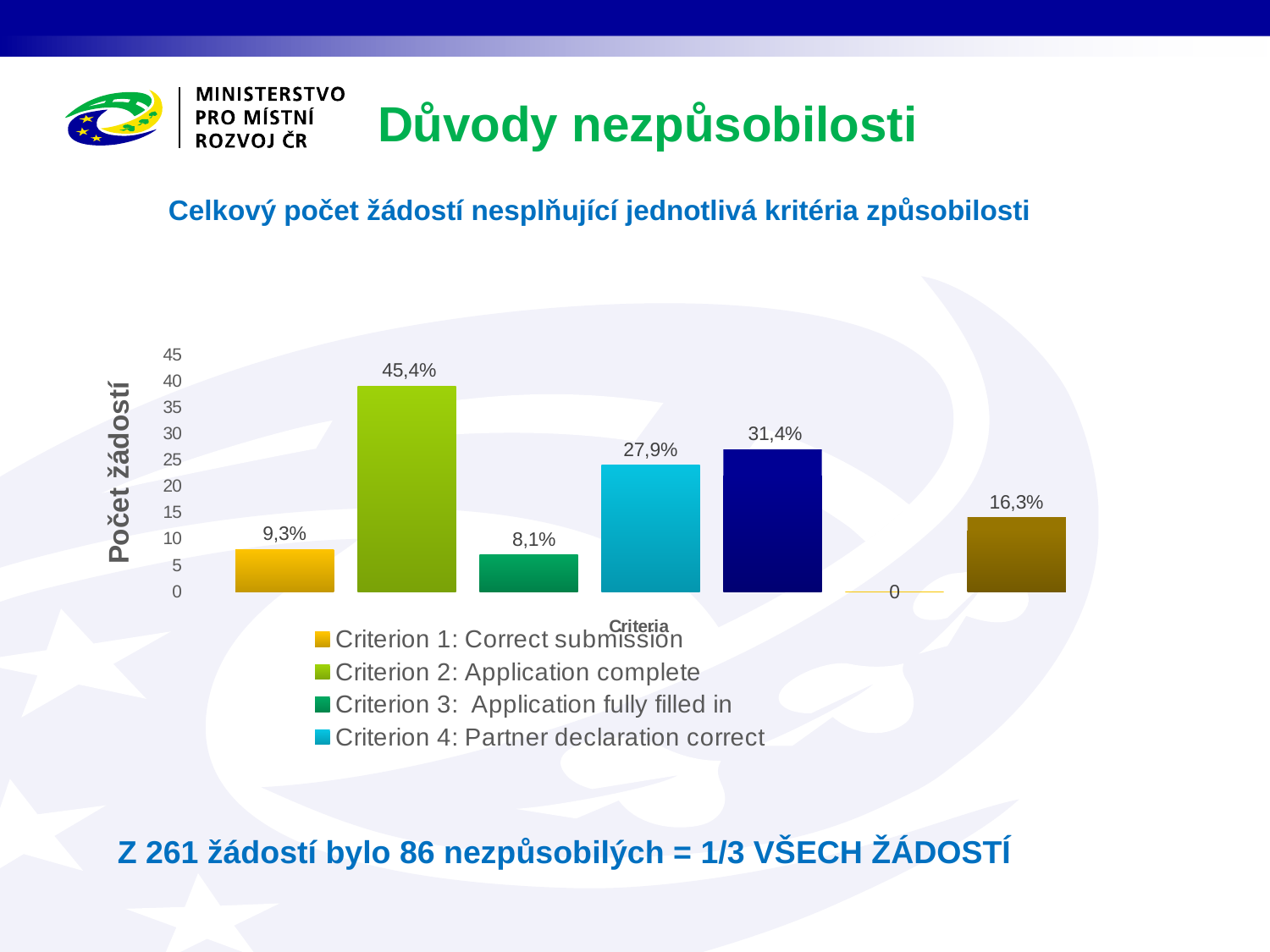
What data label is shown on the bar for Criterion 1: Correct submission? 9,3% Which is larger, the value for Criterion 1: Correct submission or for Criterion 3: Application fully filled in? Criterion 1: Correct submission What data label is shown on the bar for Criterion 3: Application fully filled in? 8,1% What data label is shown on the bar for Criterion 2: Application complete? 45,4% How many entries does the chart legend list? 4 Of the four criteria listed in the legend, which has the lowest value? Criterion 3: Application fully filled in Is the bar for Criterion 2: Application complete greater or less than 35 on the y axis? greater What is the title of the y axis of the chart? Počet žádostí What is the difference between the data labels for Criterion 2: Application complete and Criterion 1: Correct submission? 36,1% Which criterion has the tallest bar in the chart? Criterion 2: Application complete What data label is shown on the bar for Criterion 4: Partner declaration correct? 27,9% What kind of chart is shown on the slide? bar chart